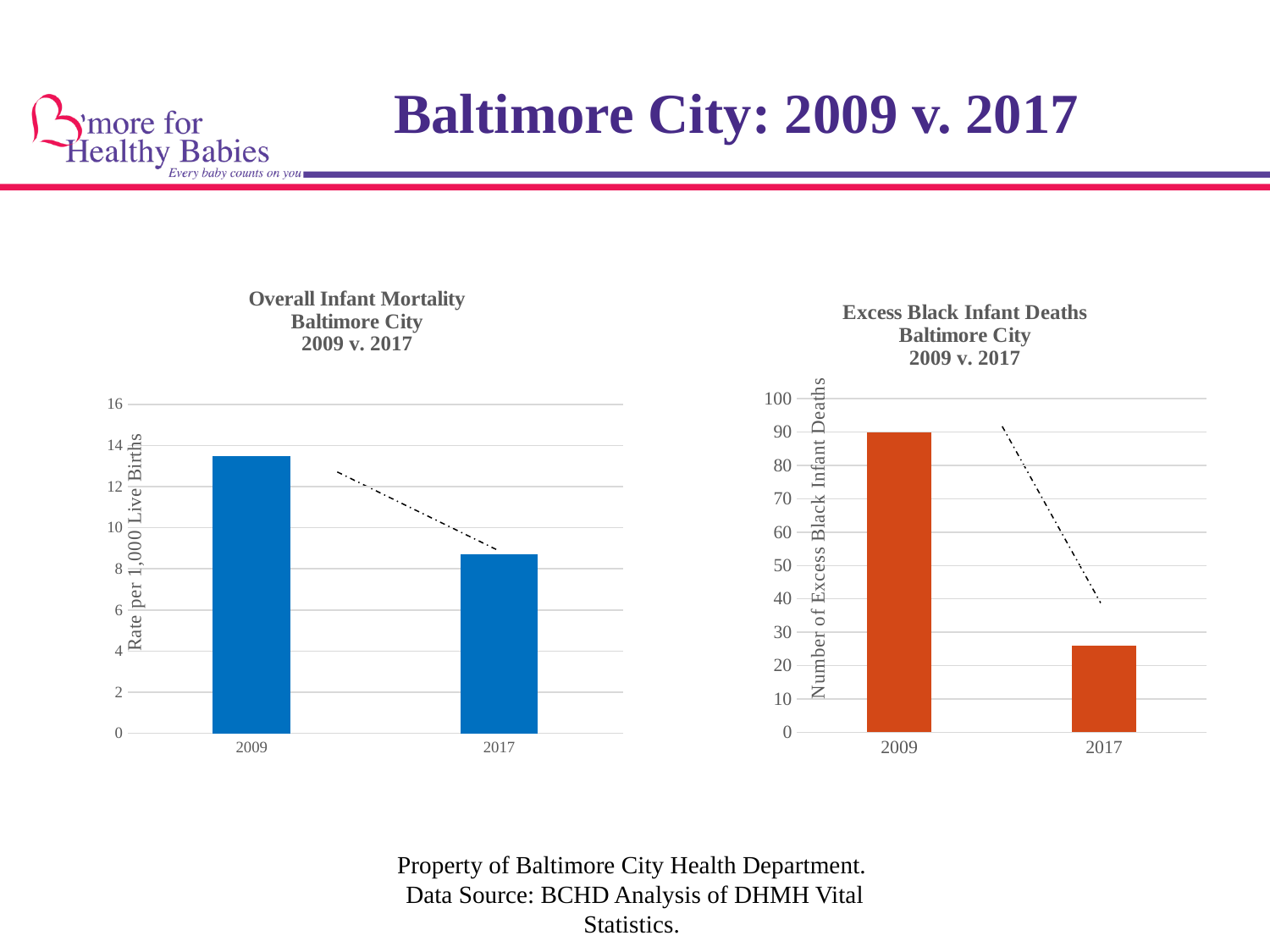
What colour are the bars in the Excess Black Infant Deaths chart? orange In the Excess Black Infant Deaths chart, is the value for 2009 greater or less than 80? greater What kind of chart is the Overall Infant Mortality chart? bar chart In the Excess Black Infant Deaths chart, is the value for 2017 greater or less than 30? less In the Overall Infant Mortality chart, which year has the higher rate? 2009 In the Overall Infant Mortality chart, is the value for 2009 greater or less than 12? greater In the Excess Black Infant Deaths chart, which year has the lower value? 2017 What is the y-axis label of the Overall Infant Mortality chart? Rate per 1,000 Live Births In the Overall Infant Mortality chart, does the rate rise or fall from 2009 to 2017? fall In the Excess Black Infant Deaths chart, is the value for 2009 larger or smaller than the value for 2017? larger How many years are shown in the Overall Infant Mortality chart? 2